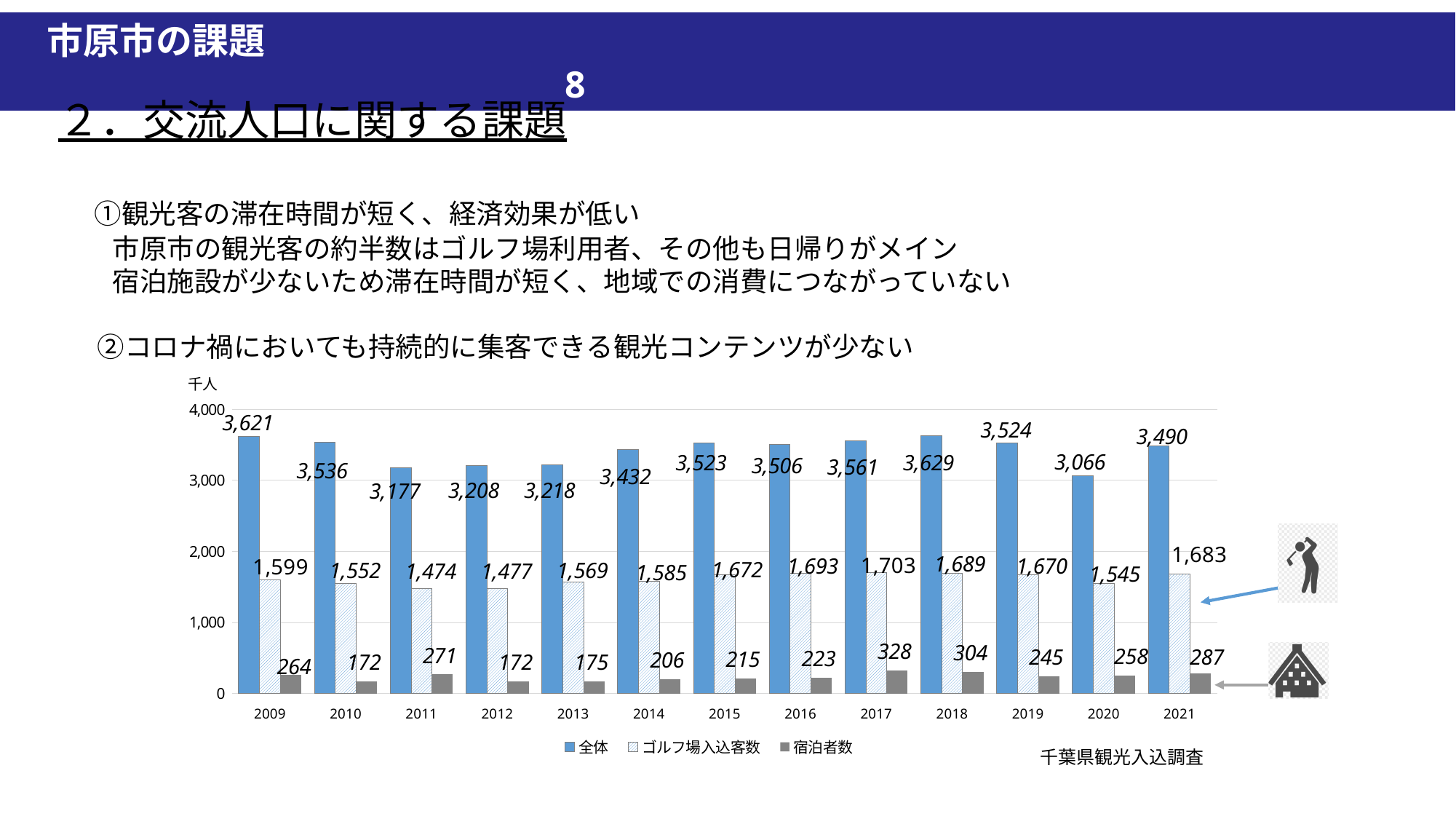
What type of chart is shown on the slide? bar chart In which year is 全体 lowest? 2020 In which year is 全体 highest? 2018 What is the value of ゴルフ場入込客数 for 2017? 1,703 How many years are shown on the x axis of the chart? 13 What is the difference between 全体 in 2021 and 全体 in 2020? 424 What unit is shown at the top of the vertical axis? 千人 Which is larger, 宿泊者数 in 2011 or 宿泊者数 in 2012? 2011 In which year is 宿泊者数 highest? 2017 What is the value of 宿泊者数 for 2021? 287 How many series does the chart legend list? 3 What is the value of 全体 for 2020? 3,066